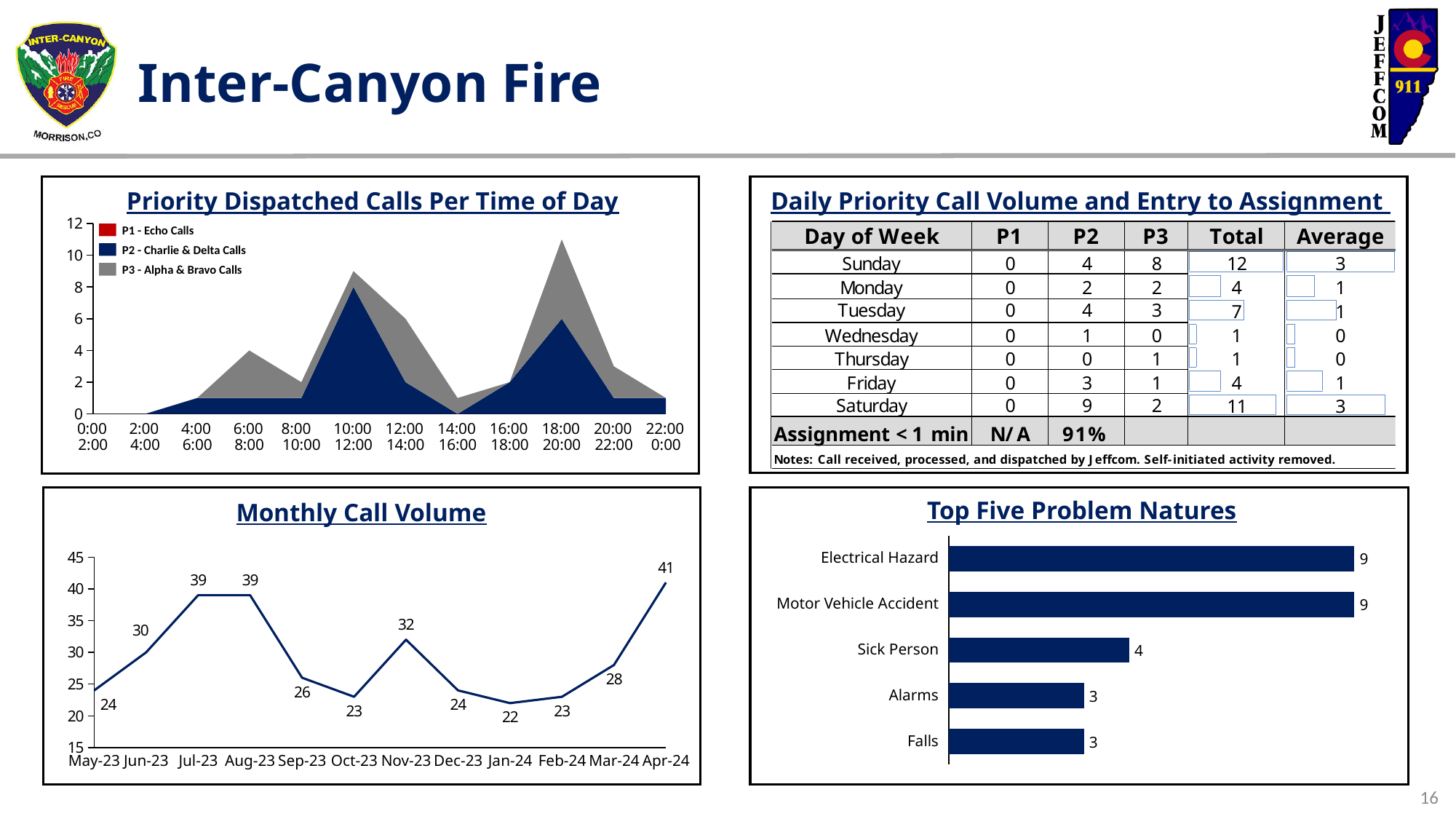
On the Priority Dispatched Calls Per Time of Day chart, how many series does the legend list? 3 On the Top Five Problem Natures chart, which is larger, Motor Vehicle Accident or Alarms? Motor Vehicle Accident On the Priority Dispatched Calls Per Time of Day chart, is the total value for 18:00-20:00 greater or less than 10? greater What kind of chart is the Monthly Call Volume chart? line chart On the Monthly Call Volume chart, what is the difference between the values for Apr-24 and Jan-24? 19 On the Monthly Call Volume chart, what is the value for Apr-24? 41 On the Monthly Call Volume chart, which month has the lowest call volume? Jan-24 What kind of chart is the Top Five Problem Natures chart? bar chart On the Monthly Call Volume chart, which month has the highest call volume? Apr-24 On the Monthly Call Volume chart, how many months are plotted? 12 On the Top Five Problem Natures chart, what is the difference between Electrical Hazard and Sick Person? 5 On the Top Five Problem Natures chart, what is the value for Sick Person? 4